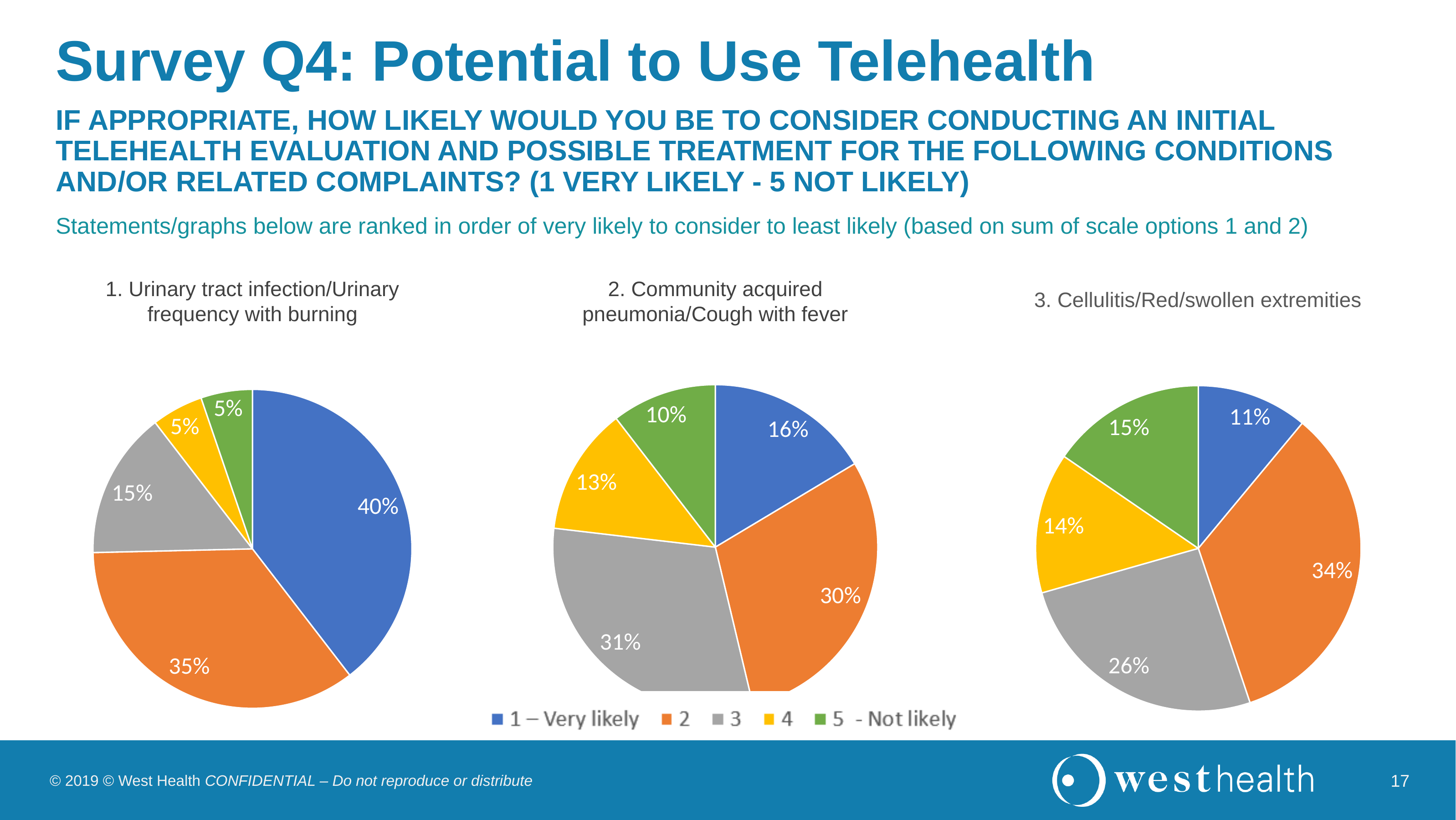
In the '2. Community acquired pneumonia/Cough with fever' pie chart, what is the combined share of the '1 – Very likely' and '2' slices? 46% In the '1. Urinary tract infection/Urinary frequency with burning' pie chart, what share is labelled for the '1 – Very likely' slice? 40% In the '2. Community acquired pneumonia/Cough with fever' pie chart, what share is labelled for the '3' slice? 31% In the '3. Cellulitis/Red/swollen extremities' pie chart, which scale option has the smallest slice? 1 – Very likely How many entries does the shared legend list? 5 In the '1. Urinary tract infection/Urinary frequency with burning' pie chart, what is the difference between the '1 – Very likely' slice and the '2' slice? 5% How many slices does the '1. Urinary tract infection/Urinary frequency with burning' pie chart have? 5 What kind of chart is used for '3. Cellulitis/Red/swollen extremities'? Pie chart What colour represents the '3' scale option in the legend? Grey In the '3. Cellulitis/Red/swollen extremities' pie chart, which is larger: the '4' slice or the '5 - Not likely' slice? 5 - Not likely In the '3. Cellulitis/Red/swollen extremities' pie chart, what share is labelled for the '2' slice? 34% In the '2. Community acquired pneumonia/Cough with fever' pie chart, which scale option has the largest slice? 3